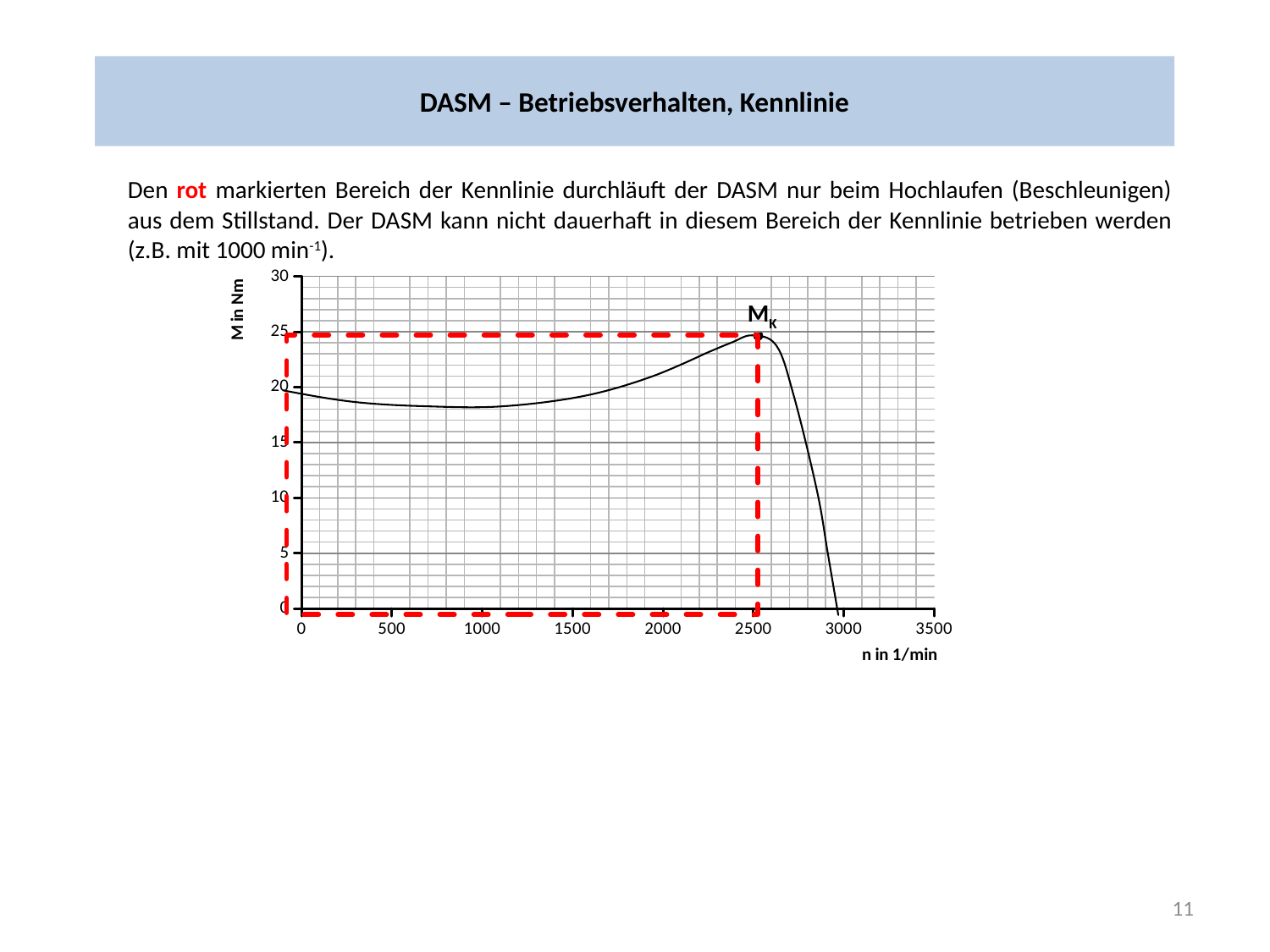
Is the value of M at n = 0 greater or less than 15? greater Is the value of M at n = 500 greater or less than 25? less How many tick labels are shown on the x axis of the chart? 8 Is the peak value of M at M_K greater or less than 20? greater What label marks the peak of the curve in the chart? M_K Does the curve rise or fall between n = 2500 and n = 3000? fall Does the curve rise or fall between n = 1000 and n = 2500? rise What is the label of the y axis of the chart? M in Nm What kind of chart is shown on the slide? line chart